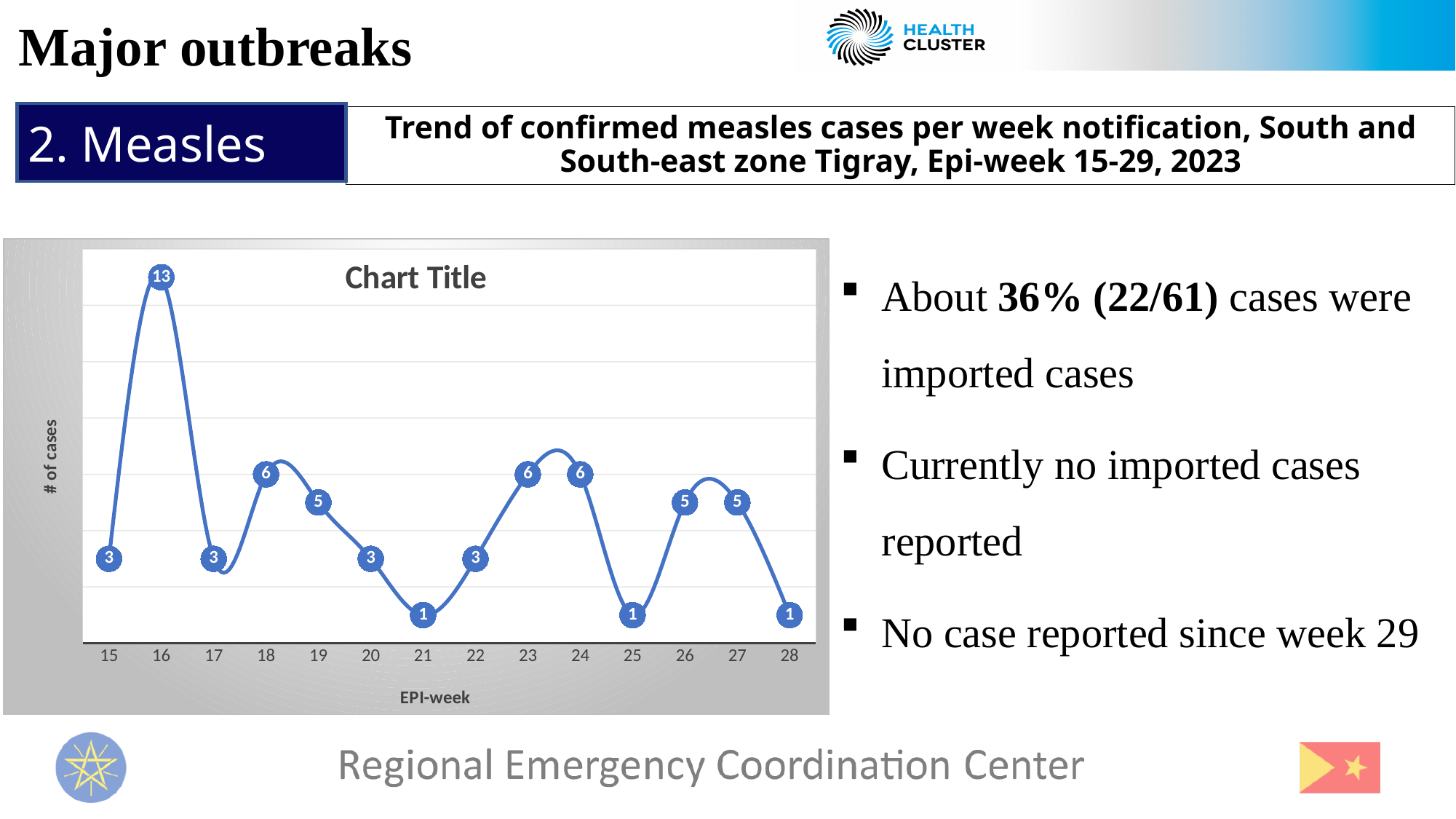
What kind of chart is shown on the slide? Line chart Which has more cases, EPI-week 15 or EPI-week 26? EPI-week 26 Do the cases rise or fall from EPI-week 24 to EPI-week 25? Fall What is the number of cases in EPI-week 16? 13 What is the number of cases in EPI-week 19? 5 What is the label of the x axis of the chart? EPI-week What is the difference in cases between EPI-week 18 and EPI-week 21? 5 What is the number of cases in EPI-week 28? 1 Which EPI-week has the highest number of cases? 16 What is the difference in cases between EPI-week 16 and EPI-week 17? 10 How many EPI-weeks are plotted on the x axis? 14 Which has more cases, EPI-week 23 or EPI-week 25? EPI-week 23